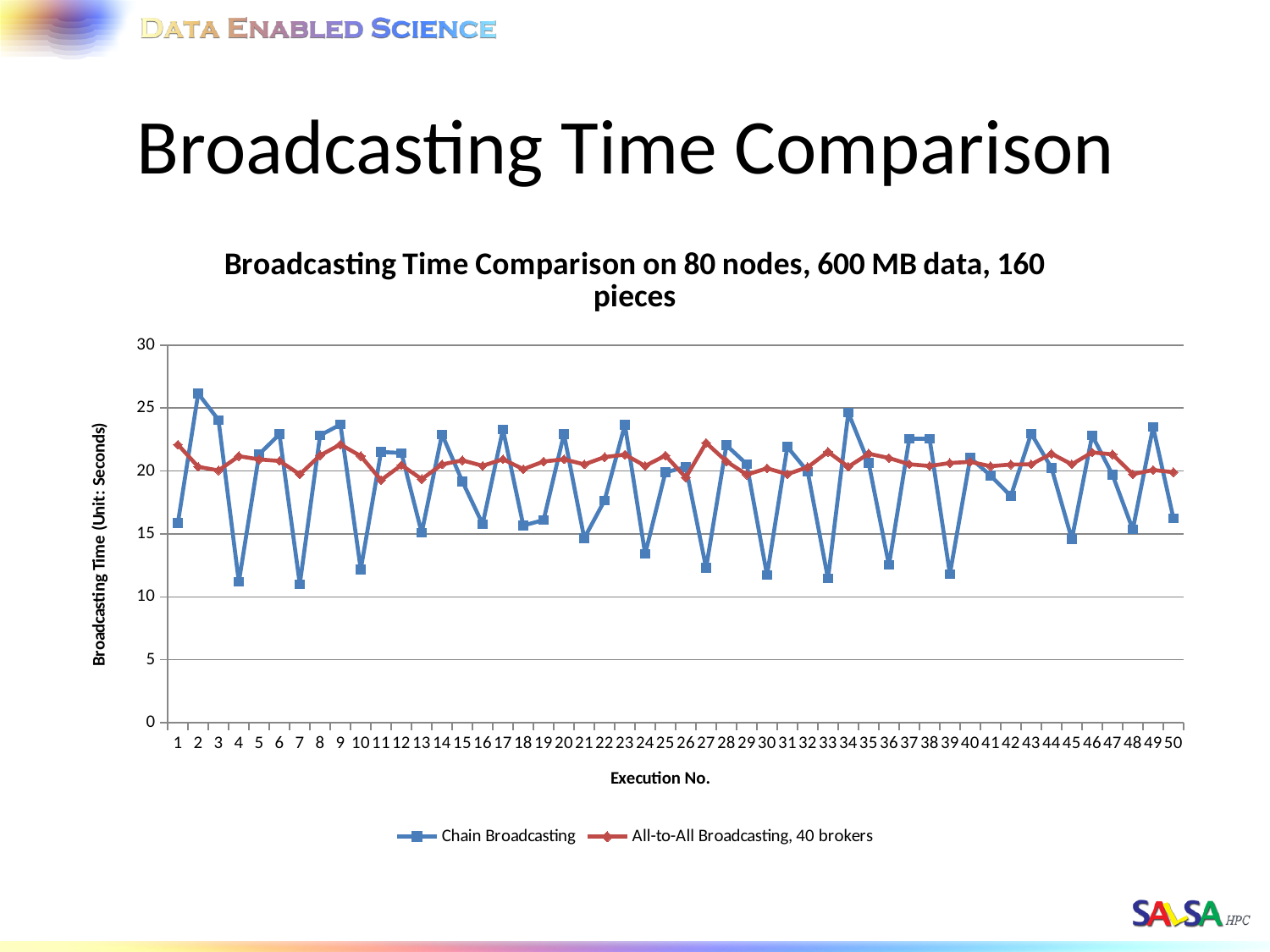
At which execution number does Chain Broadcasting reach its highest value? 2 How many execution numbers are plotted along the x axis? 50 What kind of chart is shown on the slide? Line chart How many series does the legend list? 2 Is the Chain Broadcasting value at execution 4 greater or less than 15? less What is the label of the y axis? Broadcasting Time (Unit: Seconds) At execution 4, which series has the higher value, Chain Broadcasting or All-to-All Broadcasting, 40 brokers? All-to-All Broadcasting, 40 brokers Is the All-to-All Broadcasting, 40 brokers value at execution 1 greater or less than 20? greater Is the Chain Broadcasting value at execution 7 greater or less than 15? less At execution 2, which series has the higher value, Chain Broadcasting or All-to-All Broadcasting, 40 brokers? Chain Broadcasting What is the title of the chart? Broadcasting Time Comparison on 80 nodes, 600 MB data, 160 pieces